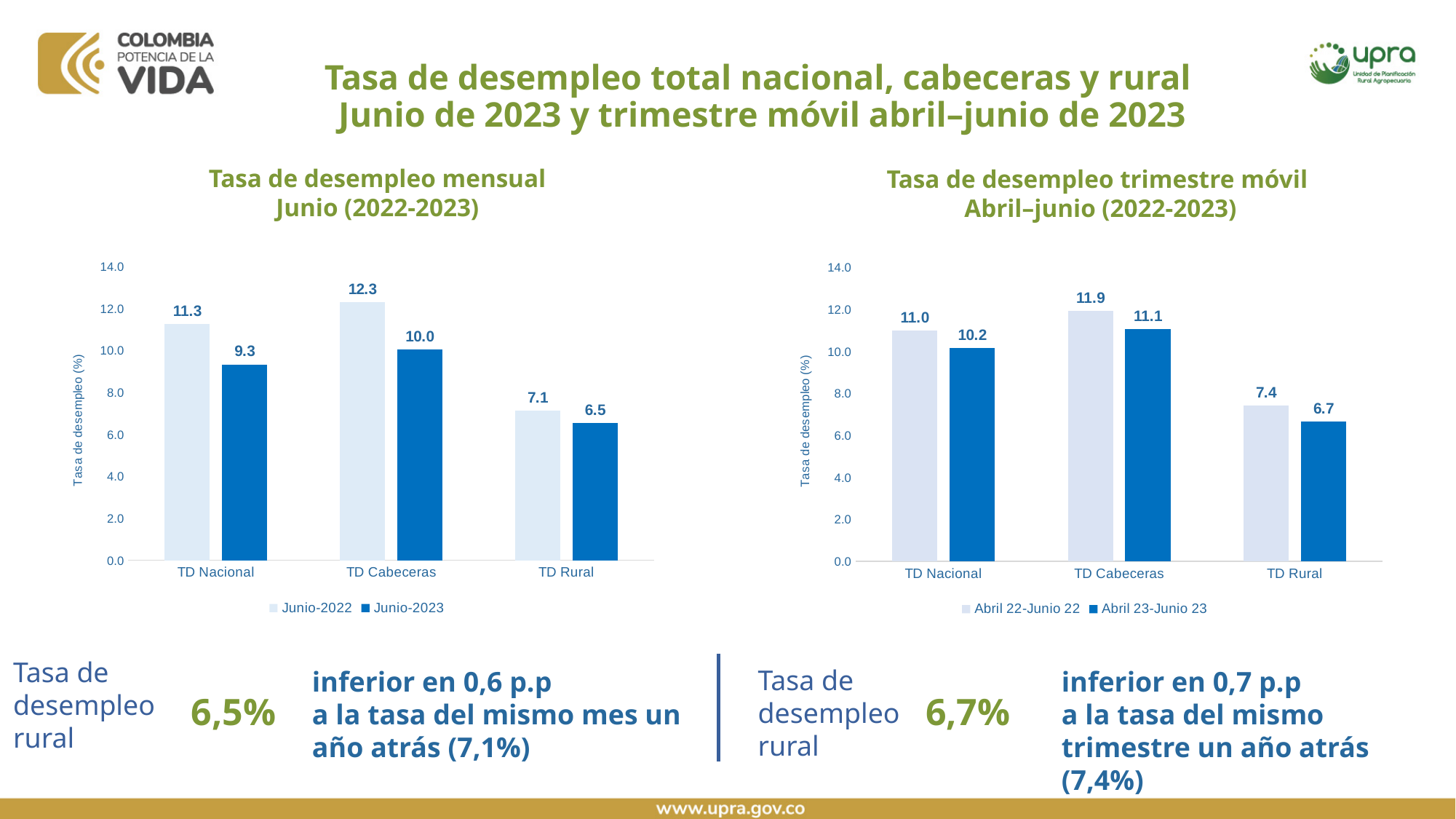
What type of chart is the left chart (Tasa de desempleo mensual Junio)? Bar chart What is the y-axis label of the right chart (Tasa de desempleo trimestre móvil)? Tasa de desempleo (%) In the right chart (Tasa de desempleo trimestre móvil), what is the value for TD Rural in Abril 23-Junio 23? 6.7 In the right chart (Tasa de desempleo trimestre móvil), which is larger for TD Cabeceras: Abril 22-Junio 22 or Abril 23-Junio 23? Abril 22-Junio 22 In the left chart (Tasa de desempleo mensual Junio), what is the difference between the Junio-2022 and Junio-2023 values for TD Cabeceras? 2.3 How many series does the legend of the right chart (Tasa de desempleo trimestre móvil) list? 2 In the right chart (Tasa de desempleo trimestre móvil), what is the difference between the Abril 22-Junio 22 and Abril 23-Junio 23 values for TD Nacional? 0.8 In the left chart (Tasa de desempleo mensual Junio), what is the value for TD Cabeceras in Junio-2022? 12.3 In the left chart (Tasa de desempleo mensual Junio), what is the value for TD Nacional in Junio-2023? 9.3 In the left chart (Tasa de desempleo mensual Junio), which category has the lowest value for Junio-2023? TD Rural In the right chart (Tasa de desempleo trimestre móvil), which category has the highest value for Abril 22-Junio 22? TD Cabeceras How many categories are shown on the x axis of the left chart (Tasa de desempleo mensual Junio)? 3